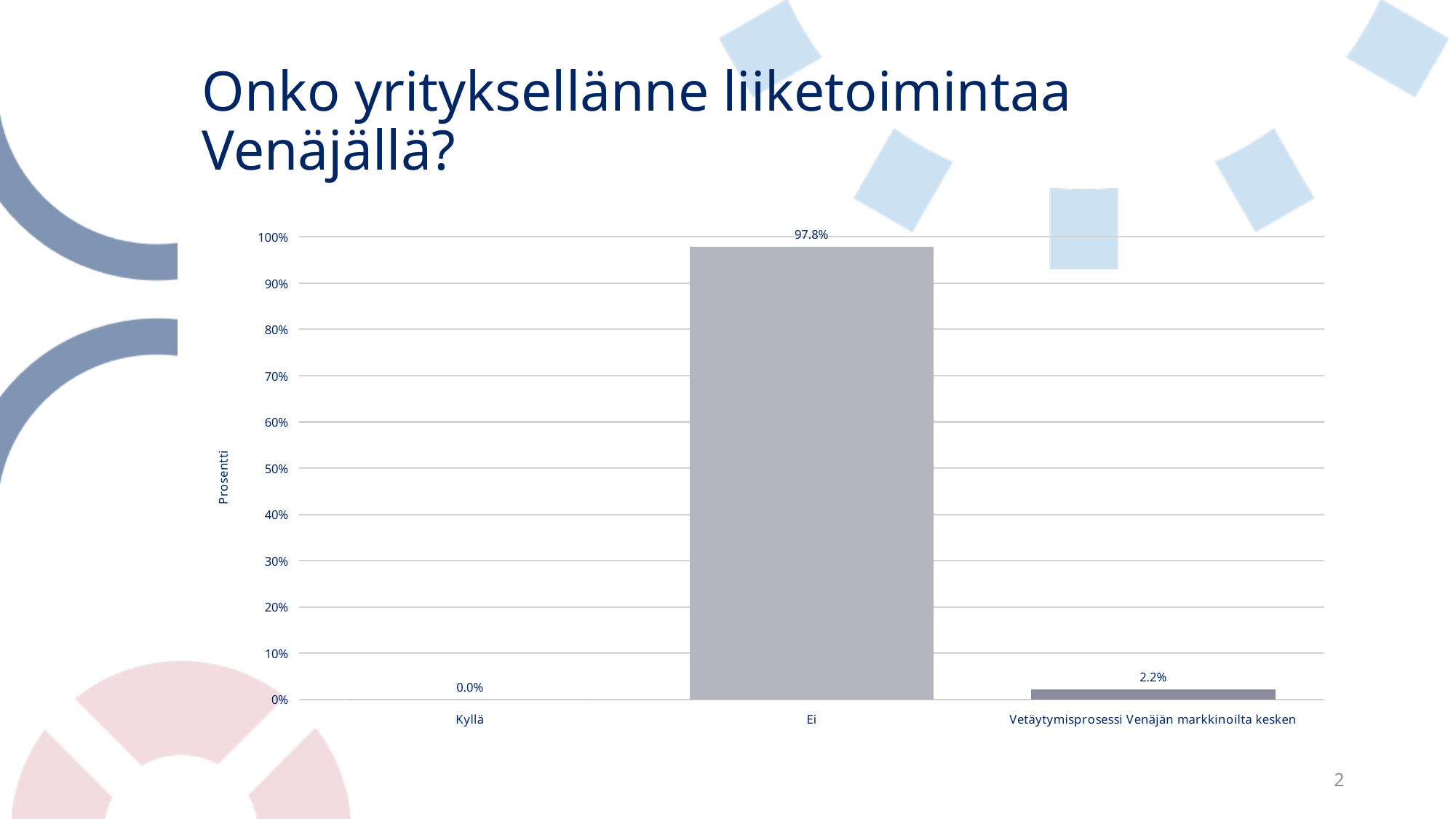
Is the value for Vetäytymisprosessi Venäjän markkinoilta kesken greater or less than 10%? less What is the difference between the values for Ei and Vetäytymisprosessi Venäjän markkinoilta kesken? 95.6% What is the value for Kyllä? 0.0% What is the value for Vetäytymisprosessi Venäjän markkinoilta kesken? 2.2% How many categories are shown on the x axis? 3 Which category has the lowest value? Kyllä What is the value for Ei? 97.8% Which is larger, the value for Ei or the value for Kyllä? Ei Is the value for Ei greater or less than 90%? greater What kind of chart is shown on the slide? bar chart What is the label of the vertical axis? Prosentti Which category has the highest value? Ei